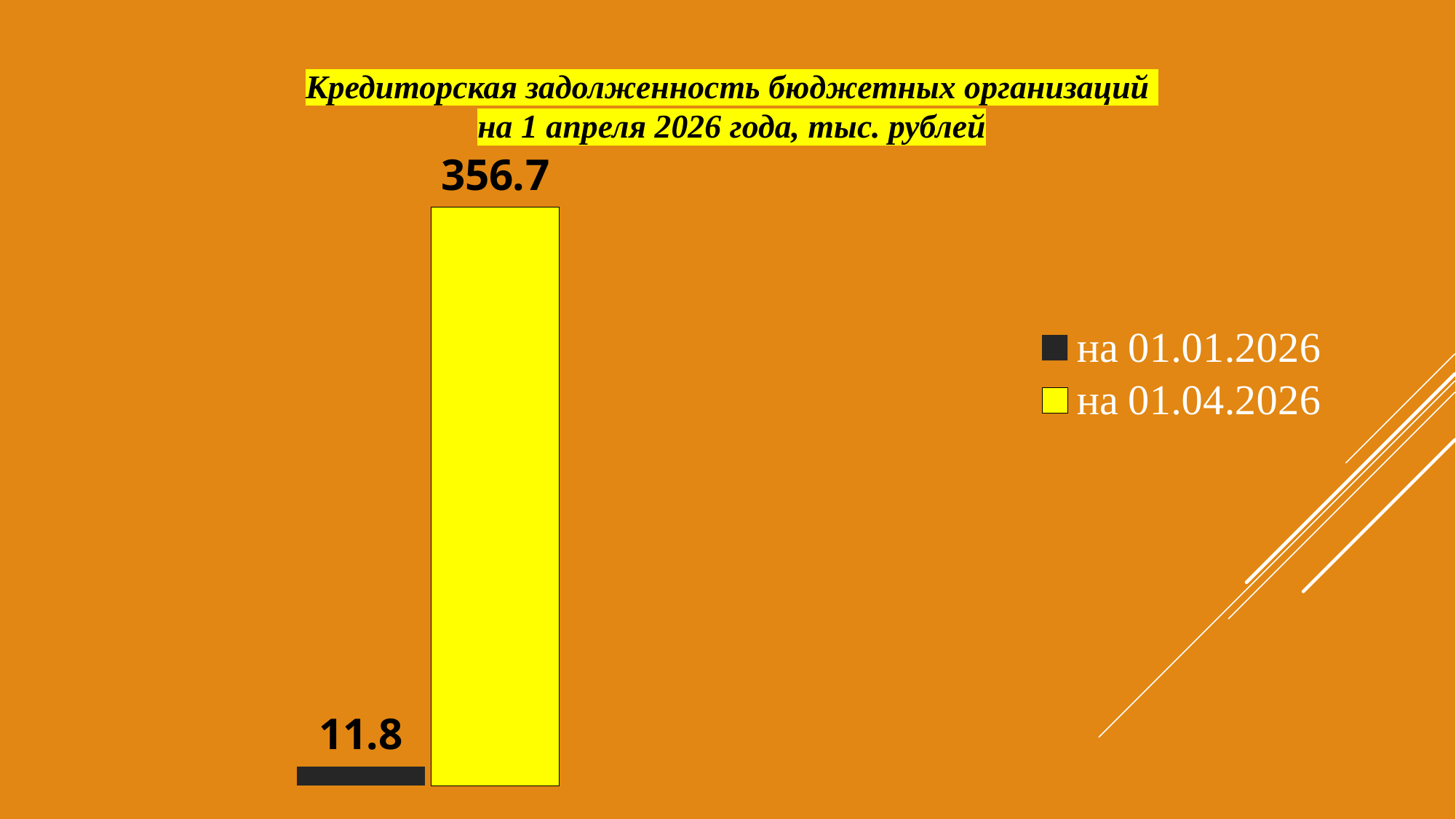
What is the value for "на 01.01.2026"? 11.8 What kind of chart is shown on the slide? bar chart What is the difference between the values for "на 01.04.2026" and "на 01.01.2026"? 344.9 How many series does the legend list? 2 How many bars are plotted on the chart? 2 Which series has the highest value? на 01.04.2026 What is the title of the chart? Кредиторская задолженность бюджетных организаций на 1 апреля 2026 года, тыс. рублей Which series has the lowest value? на 01.01.2026 What colour is the bar for "на 01.04.2026"? yellow Which series has the higher value, "на 01.01.2026" or "на 01.04.2026"? на 01.04.2026 What is the value for "на 01.04.2026"? 356.7 Did the value rise or fall from 01.01.2026 to 01.04.2026? rise